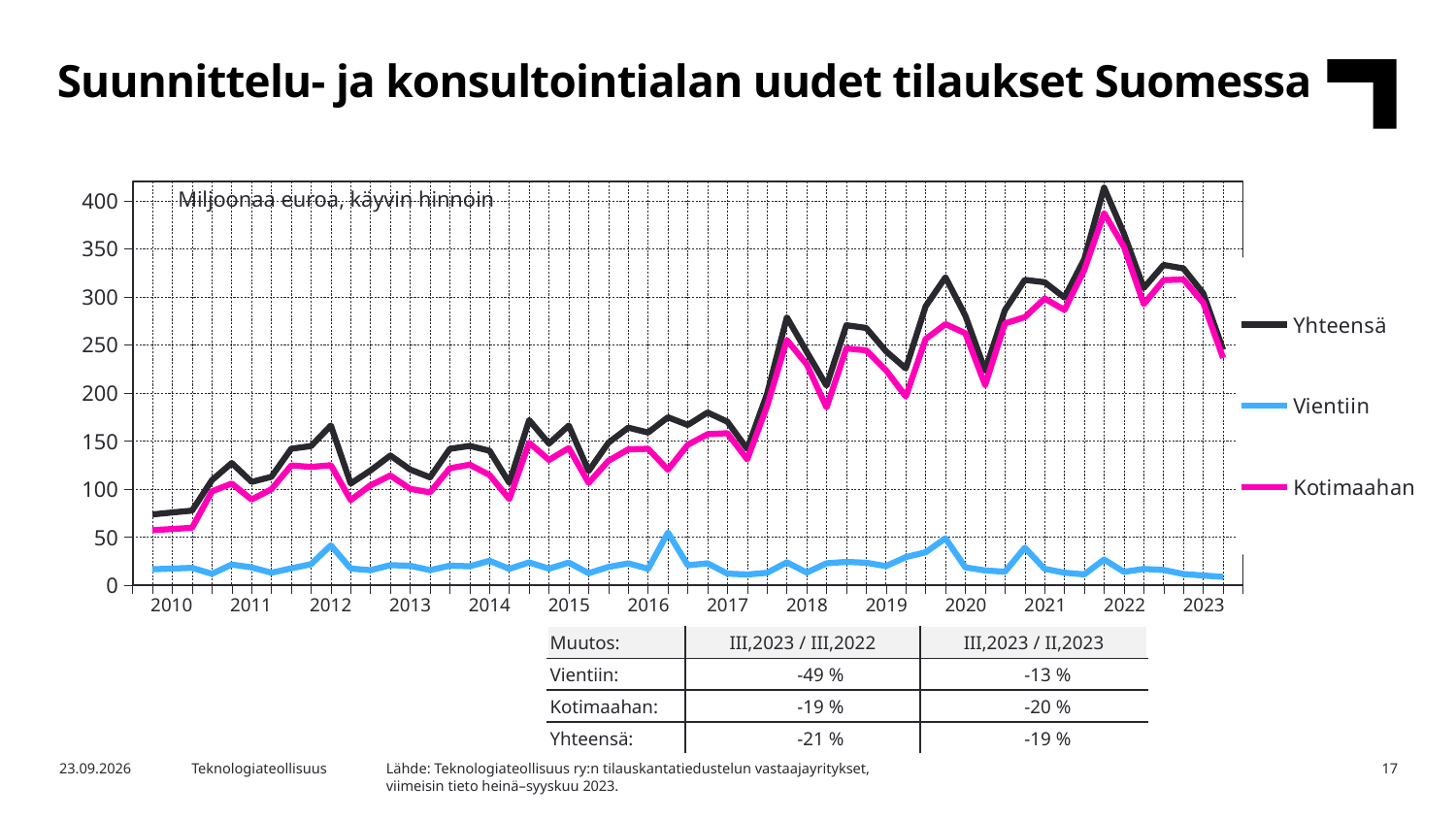
Does the Yhteensä series generally rise or fall from 2010 to the end of 2021? rise Which series has the lowest values throughout the chart? Vientiin Is the last plotted value for Vientiin in 2023 greater or less than 50? less Is the peak value of Kotimaahan in late 2021 greater or less than 350? greater Which series has the highest values throughout the chart? Yhteensä What are the three series named in the legend? Yhteensä, Vientiin, Kotimaahan How many series does the legend list? 3 Which is larger in 2020, Kotimaahan or Vientiin? Kotimaahan What kind of chart is shown on the slide? line chart What unit is stated in the chart's subtitle? Miljoonaa euroa, käyvin hinnoin Is the value for Yhteensä at the start of 2010 greater or less than 100? less